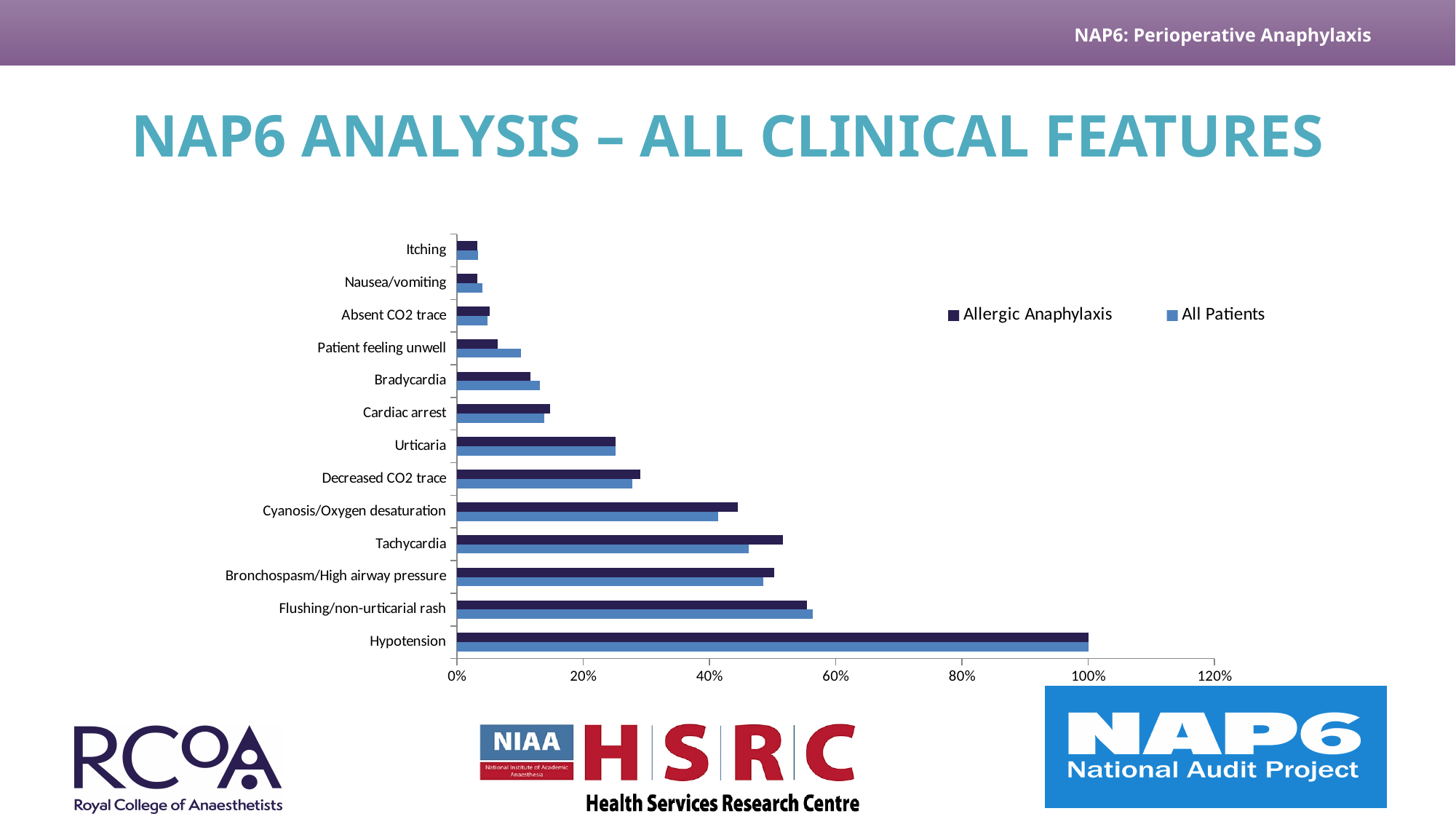
For Tachycardia, which series has the larger value: Allergic Anaphylaxis or All Patients? Allergic Anaphylaxis How many clinical features (categories) are plotted on the chart? 13 Which series is shown in dark navy bars? Allergic Anaphylaxis How many series does the legend list? 2 Which clinical feature has the highest value for Allergic Anaphylaxis? Hypotension What kind of chart is shown on the slide? Bar chart Is the All Patients value for Decreased CO2 trace greater or less than 40%? less For Patient feeling unwell, which series has the larger value: Allergic Anaphylaxis or All Patients? All Patients Is the Allergic Anaphylaxis value for Hypotension greater or less than 80%? greater Is the All Patients value for Itching greater or less than 20%? less Which clinical feature has the highest value for All Patients? Hypotension